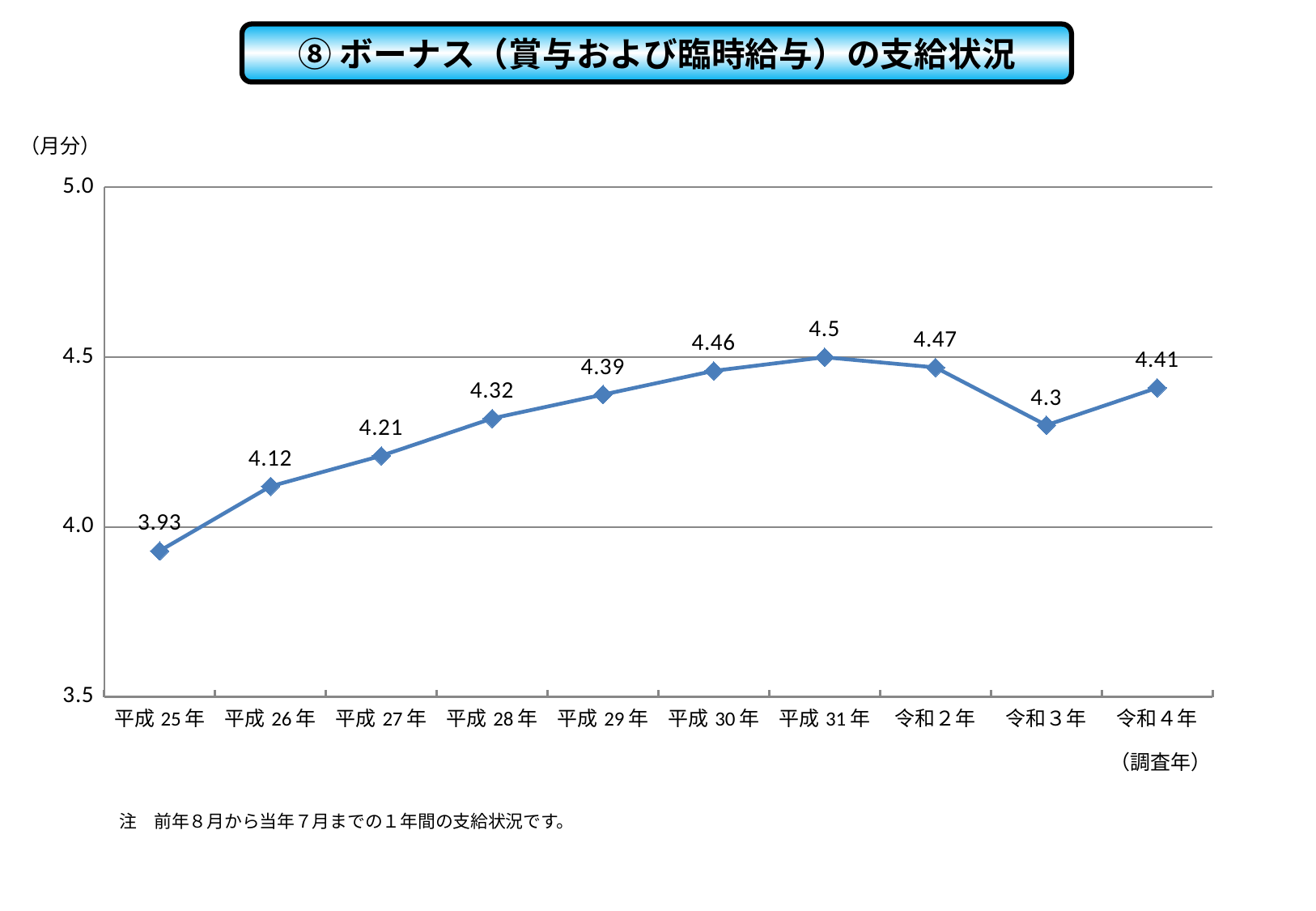
What is the difference between the bonus values for 平成31年 and 令和3年? 0.2 What is the difference between the bonus values for 令和4年 and 平成25年? 0.48 What is the bonus value for 平成29年? 4.39 What is the bonus value for 令和3年? 4.3 What is the bonus value (in months) for 平成25年? 3.93 What kind of chart is shown on the slide? line chart Which survey year has the highest bonus value? 平成31年 Does the bonus value rise or fall from 平成25年 to 平成31年? rise Which is larger, the bonus value for 平成30年 or for 令和4年? 平成30年 Which survey year has the lowest bonus value? 平成25年 Is the bonus value for 平成26年 greater or less than 4.0? greater How many survey years are plotted on the chart? 10